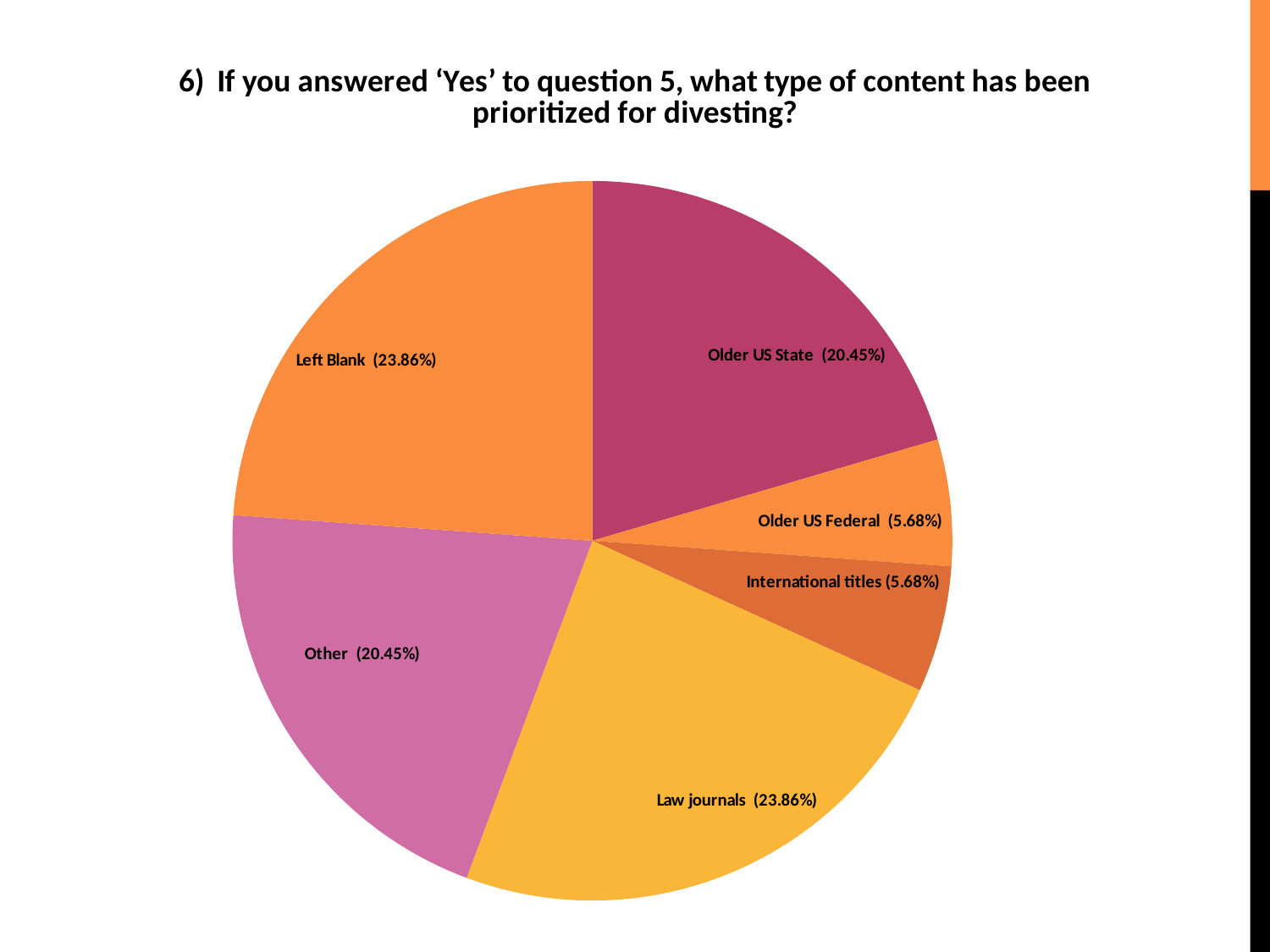
What percentage is shown for the Other slice? 20.45% What percentage is shown for Older US Federal? 5.68% How many slices does the pie chart have? 6 What percentage is shown for Older US State? 20.45% Which is larger, the share for Law journals or the share for Other? Law journals What kind of chart is shown on the slide? Pie chart What percentage is shown for Left Blank? 23.86% What is the difference in percentage points between Left Blank and Older US State? 3.41 What is the difference in percentage points between Older US State and International titles? 14.77 What share of the pie is labelled International titles? 5.68% What share of the pie does Law journals represent? 23.86% Which is larger, the share for Older US State or the share for Older US Federal? Older US State